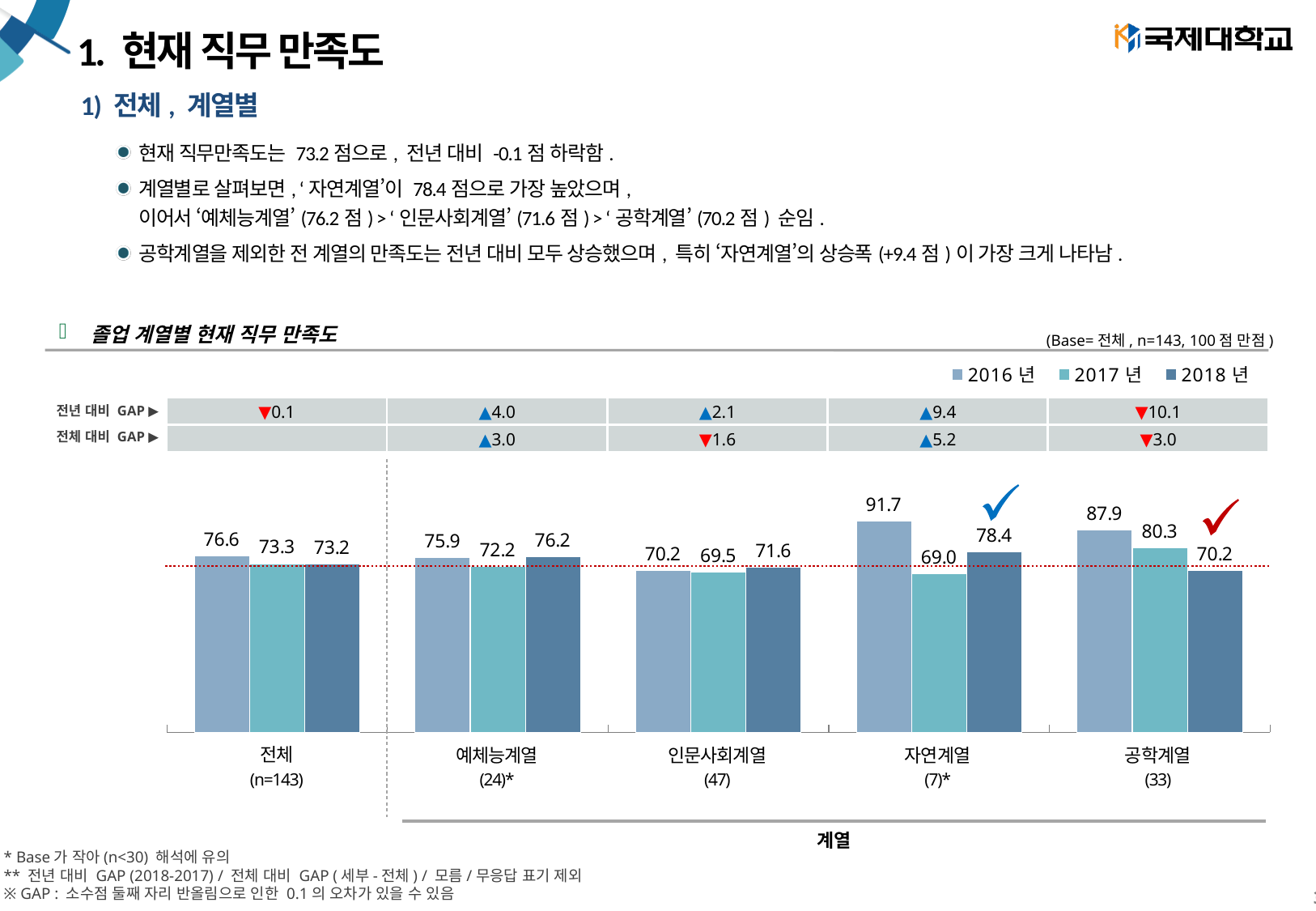
What is the difference between the 2016년 and 2017년 values for 자연계열? 22.7 Which category has the lowest 2018년 value? 공학계열 What kind of chart is shown on the slide? bar chart What is the 2018년 value for 자연계열? 78.4 For 공학계열, do the values rise or fall from 2016년 to 2018년? fall Which is larger for 예체능계열, the 2016년 value or the 2018년 value? 2018년 How many series does the legend list? 3 Which category has the highest 2016년 value? 자연계열 What is the 2017년 value for 전체? 73.3 How many categories are shown on the x axis of the chart? 5 What is the 2016년 value for 공학계열? 87.9 What is the difference between the 2018년 values for 자연계열 and 인문사회계열? 6.8